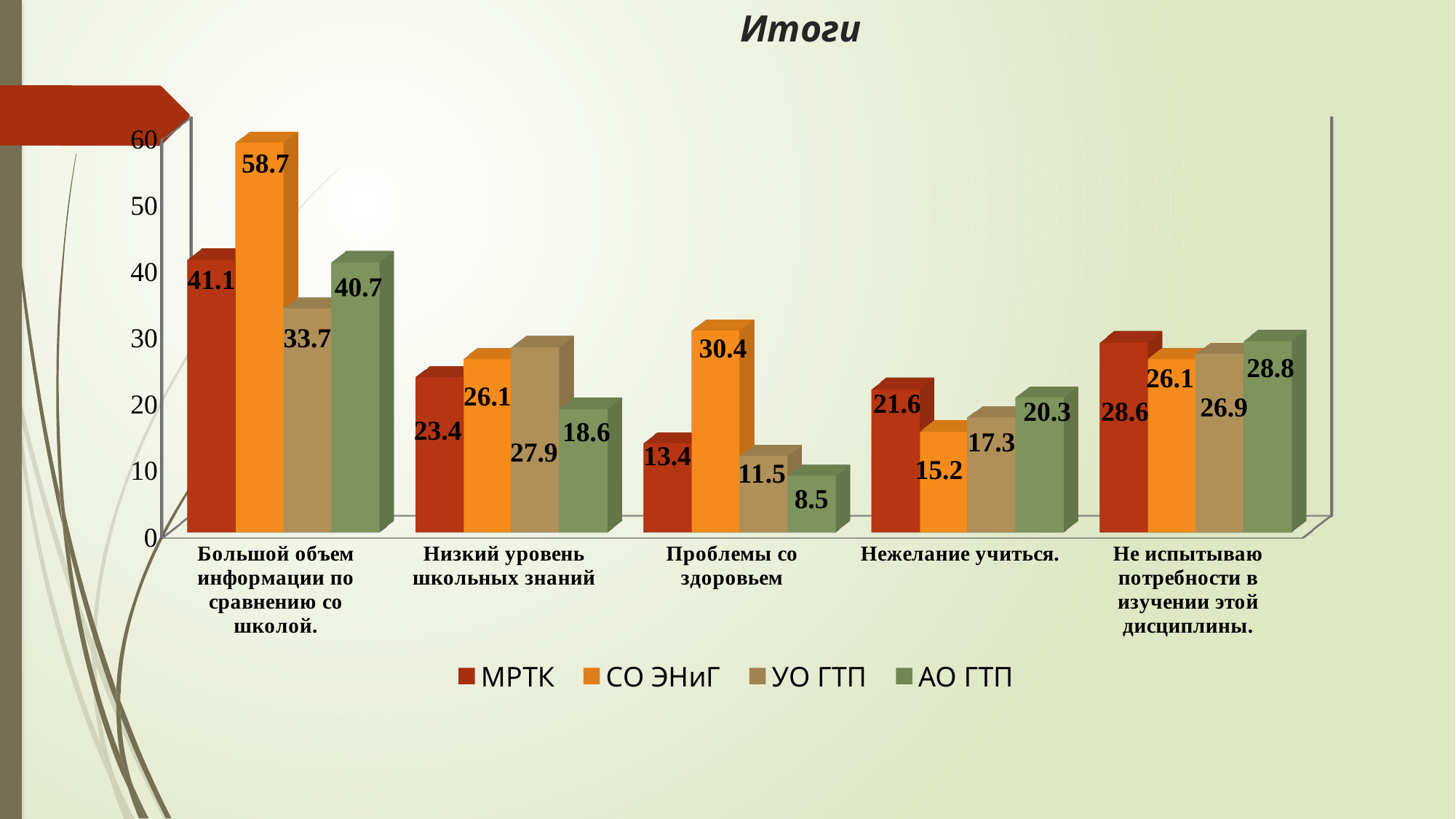
What value does the МРТК series show for the category "Не испытываю потребности в изучении этой дисциплины"? 28.6 What is the title of the slide? Итоги What value does the АО ГТП series show for the category "Проблемы со здоровьем"? 8.5 Which series has the highest value in the category "Низкий уровень школьных знаний"? УО ГТП What value does the СО ЭНиГ series show for the category "Большой объем информации по сравнению со школой"? 58.7 How many series does the legend list? 4 What value does the УО ГТП series show for the category "Нежелание учиться"? 17.3 What kind of chart is shown on the slide? Bar chart What is the difference between the СО ЭНиГ and МРТК values in the category "Большой объем информации по сравнению со школой"? 17.6 Which series has the lowest value in the category "Проблемы со здоровьем"? АО ГТП In the category "Нежелание учиться", which is larger: the МРТК value or the СО ЭНиГ value? МРТК How many categories are shown on the x axis of the chart? 5